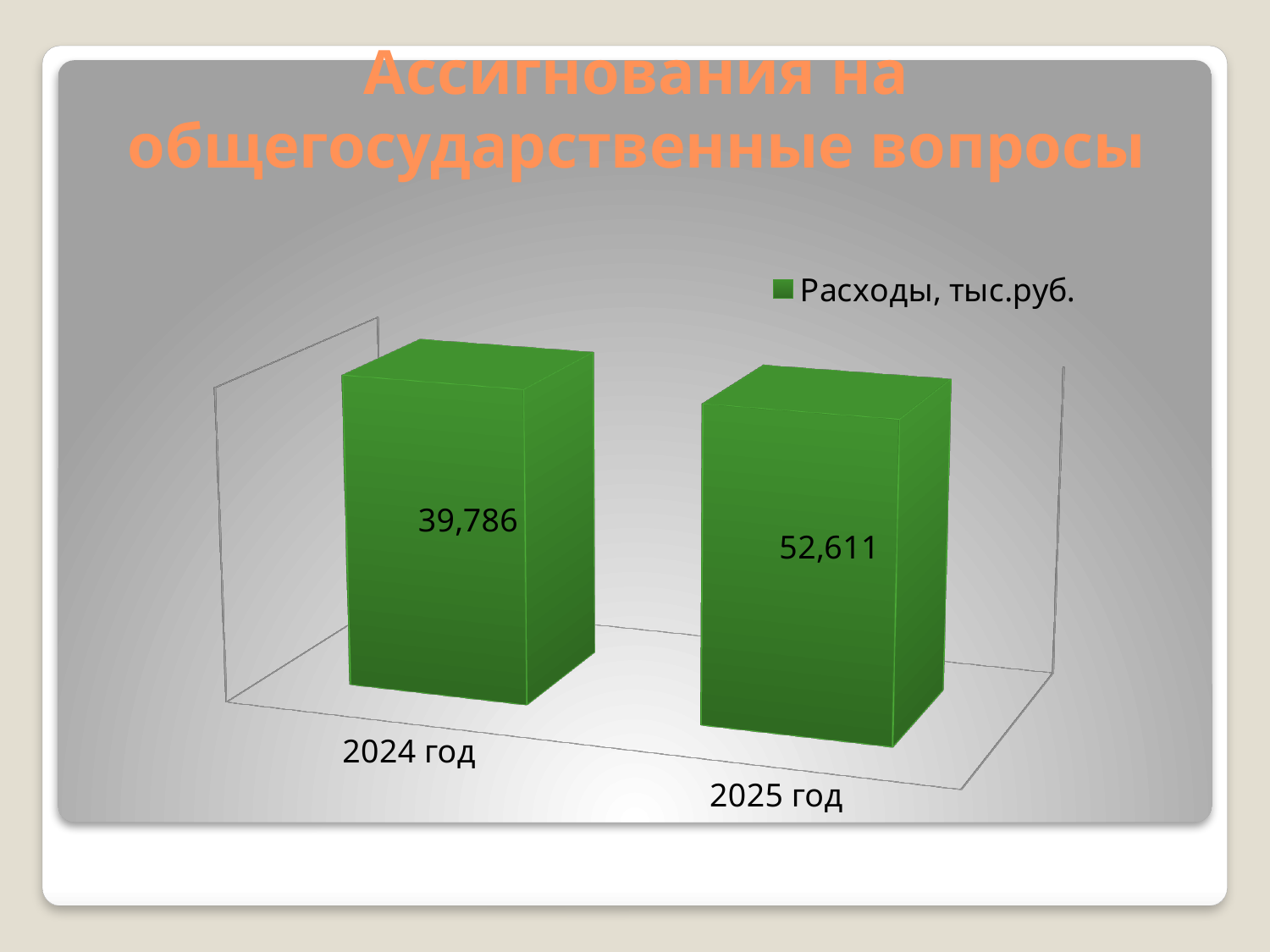
Do the values rise or fall from 2024 год to 2025 год? Rise What is the value for 2025 год? 52,611 How many categories are shown in the chart? 2 What is the title of the chart? Ассигнования на общегосударственные вопросы What kind of chart is shown on the slide? Bar chart Which year has the highest value? 2025 год Which year has the lowest value? 2024 год What is the value for 2024 год? 39,786 What series name does the legend show? Расходы, тыс.руб. How many series does the legend list? 1 What is the difference between the values for 2025 год and 2024 год? 12,825 Which is larger, the value for 2024 год or the value for 2025 год? 2025 год